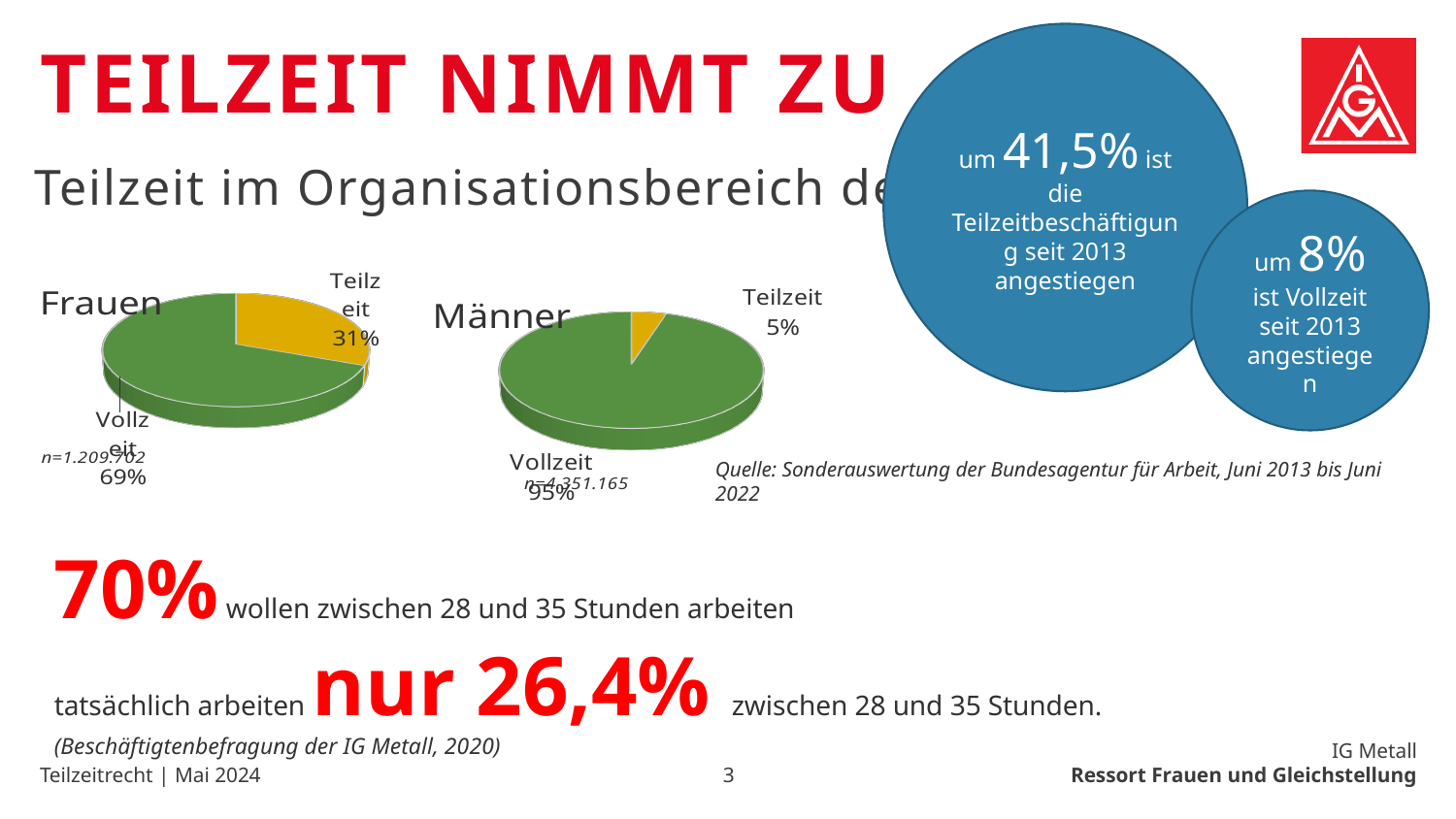
What colour is the Teilzeit slice in the Frauen pie chart? Yellow In the Frauen pie chart, what is the difference between the Vollzeit and Teilzeit shares? 38 percentage points In the Männer pie chart, which slice is the smallest? Teilzeit What is the difference between the Teilzeit share in the Frauen chart and the Teilzeit share in the Männer chart? 26 percentage points In the Männer pie chart, what share is Vollzeit? 95% In the Frauen pie chart, what share is Vollzeit? 69% In the Frauen pie chart, what share is Teilzeit? 31% In the Frauen pie chart, which slice is the largest? Vollzeit How many slices does the Frauen pie chart have? 2 In the Männer pie chart, what share is Teilzeit? 5% Which is larger: the Vollzeit share in the Männer chart or the Vollzeit share in the Frauen chart? Männer What type of chart is used for the Männer data? Pie chart